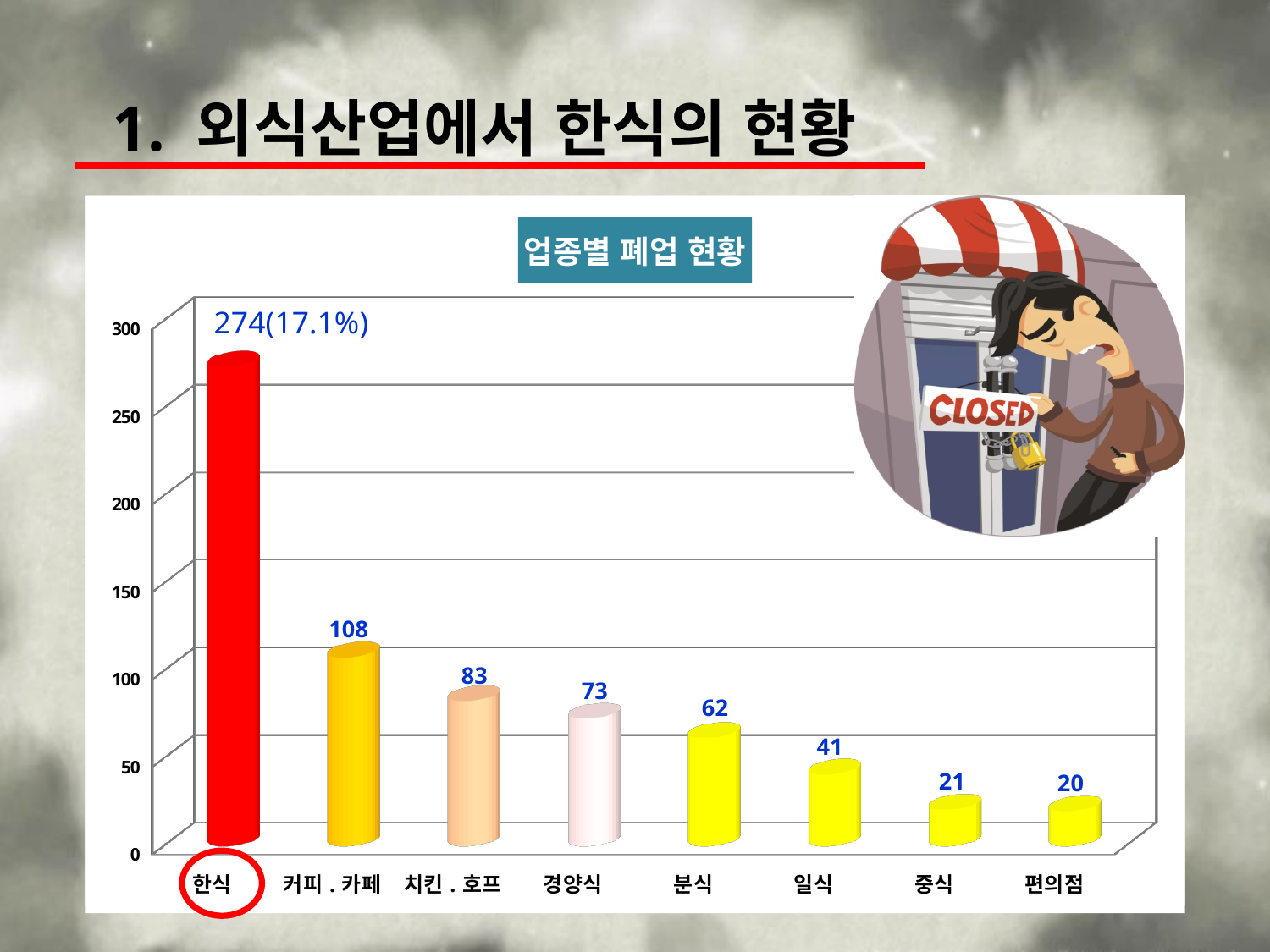
What is the value for 일식? 41 What kind of chart is shown on the slide? bar chart Which category has the highest value? 한식 Is the value for 치킨 . 호프 greater or less than 100? less How many categories are shown in the chart? 8 What is the title of the chart? 업종별 폐업 현황 What is the value for 한식 in the 업종별 폐업 현황 chart? 274(17.1%) What is the value for 분식? 62 Which category has the lowest value? 편의점 What is the value for 커피 . 카페? 108 What is the difference between the values for 커피 . 카페 and 치킨 . 호프? 25 Which is larger, the value for 경양식 or the value for 분식? 경양식